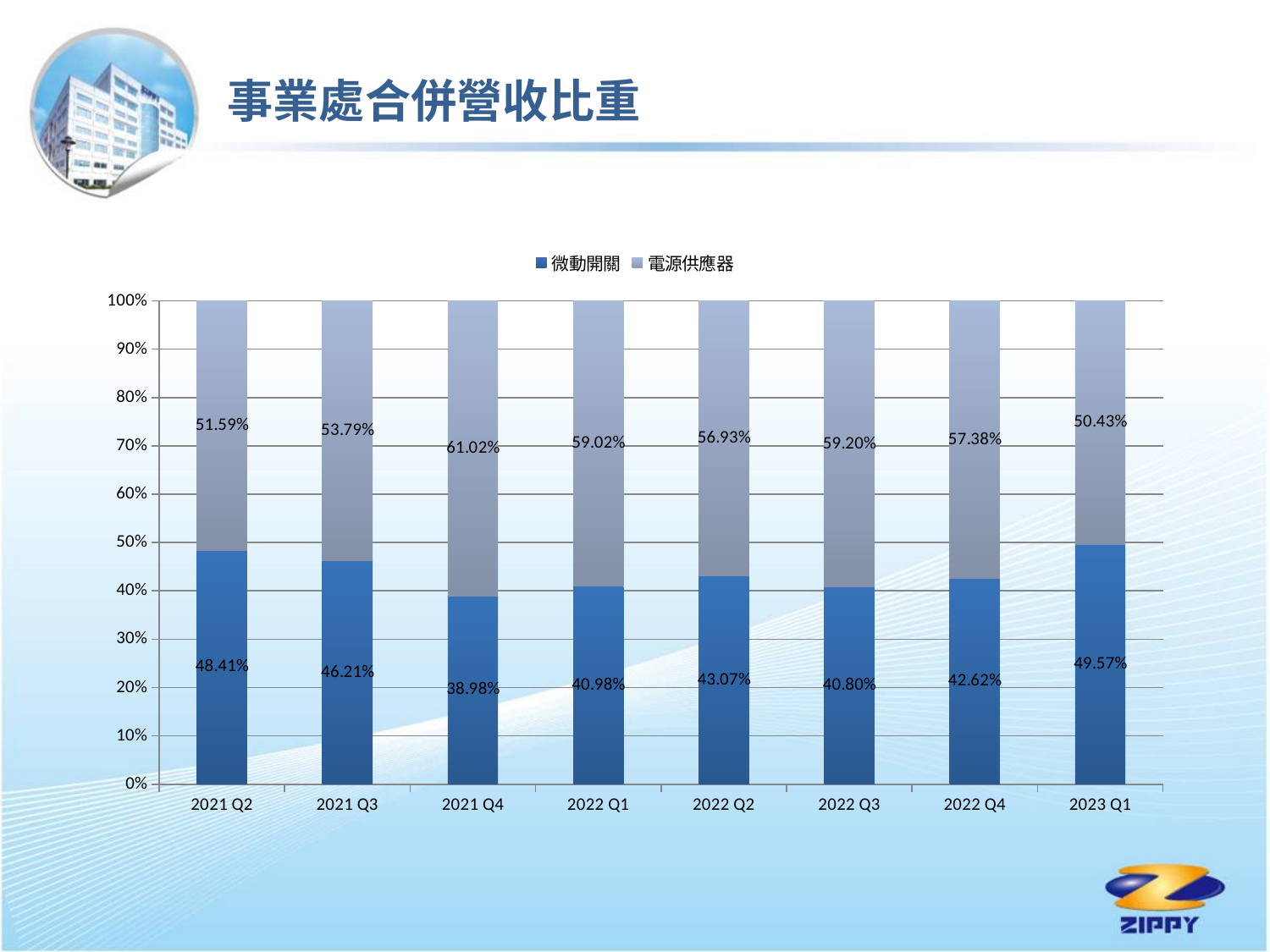
In which quarter is the 微動開關 share lowest? 2021 Q4 What is the difference between the 電源供應器 share and the 微動開關 share in 2022 Q1? 18.04% What is the title of the slide? 事業處合併營收比重 How many quarters are shown on the x axis? 8 Which is larger in 2021 Q3, the 微動開關 share or the 電源供應器 share? 電源供應器 What kind of chart is shown on the slide? Stacked bar chart What is the value for 微動開關 in 2021 Q4? 38.98% How many series does the legend list? 2 In which quarter is the 微動開關 share highest? 2023 Q1 What is the value for 電源供應器 in 2023 Q1? 50.43% What is the value for 微動開關 in 2022 Q2? 43.07% In which quarter is the 電源供應器 share highest? 2021 Q4